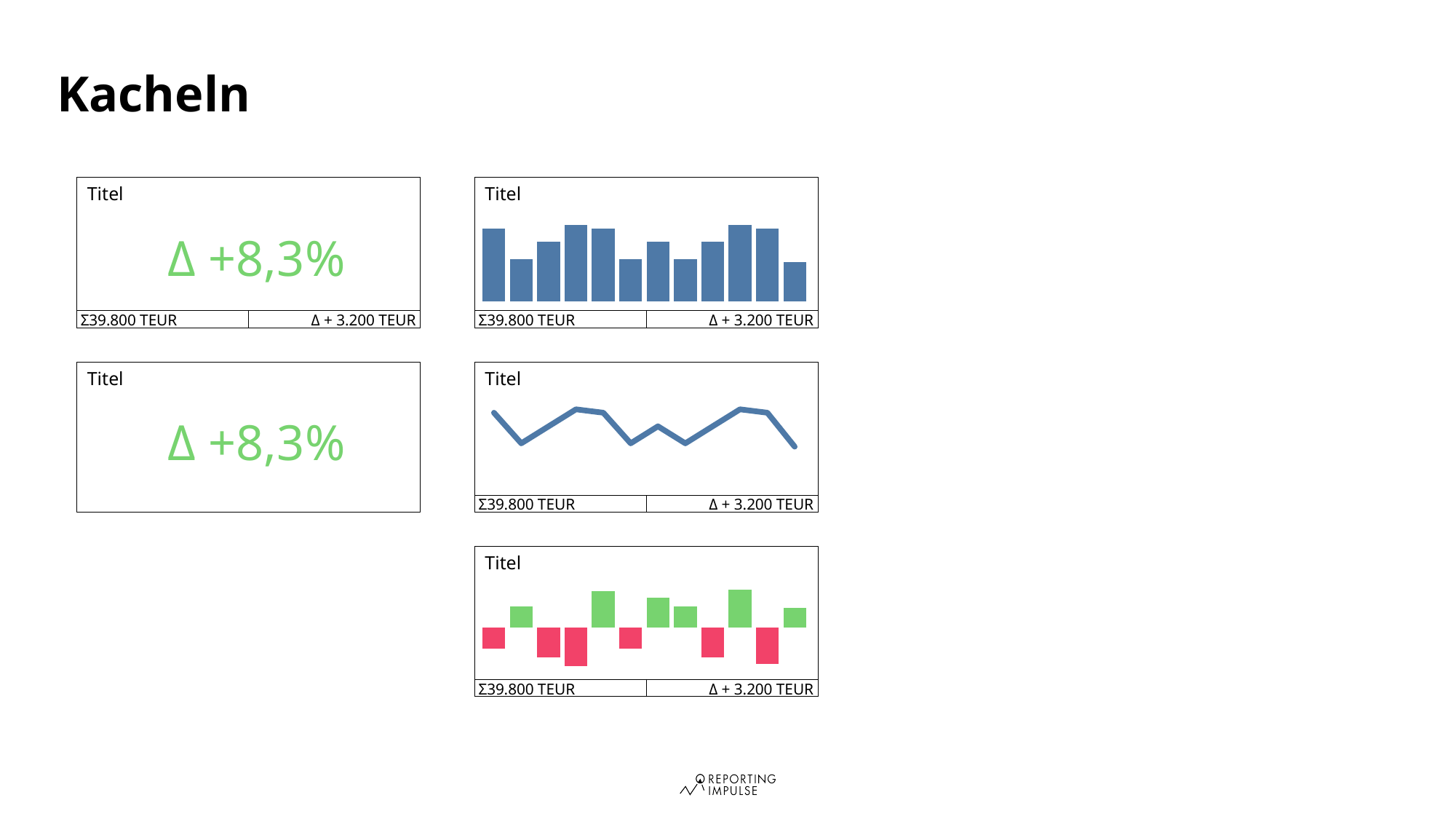
What kind of chart is shown in the bottom-right tile? bar chart What kind of chart is shown in the top-right tile? bar chart What total value is printed in the footer of the top-right bar chart tile? Σ39.800 TEUR How many bars are plotted in the bar chart in the top-right tile? 12 In the bottom-right tile's bar chart, how many bars are red (negative)? 6 What kind of chart is shown in the middle-right tile? line chart In the line chart in the middle-right tile, does the line end higher or lower than it starts? lower In the bottom-right tile's bar chart, how many bars are green (positive)? 6 What delta value is printed in the footer of the middle-right line chart tile? Δ + 3.200 TEUR